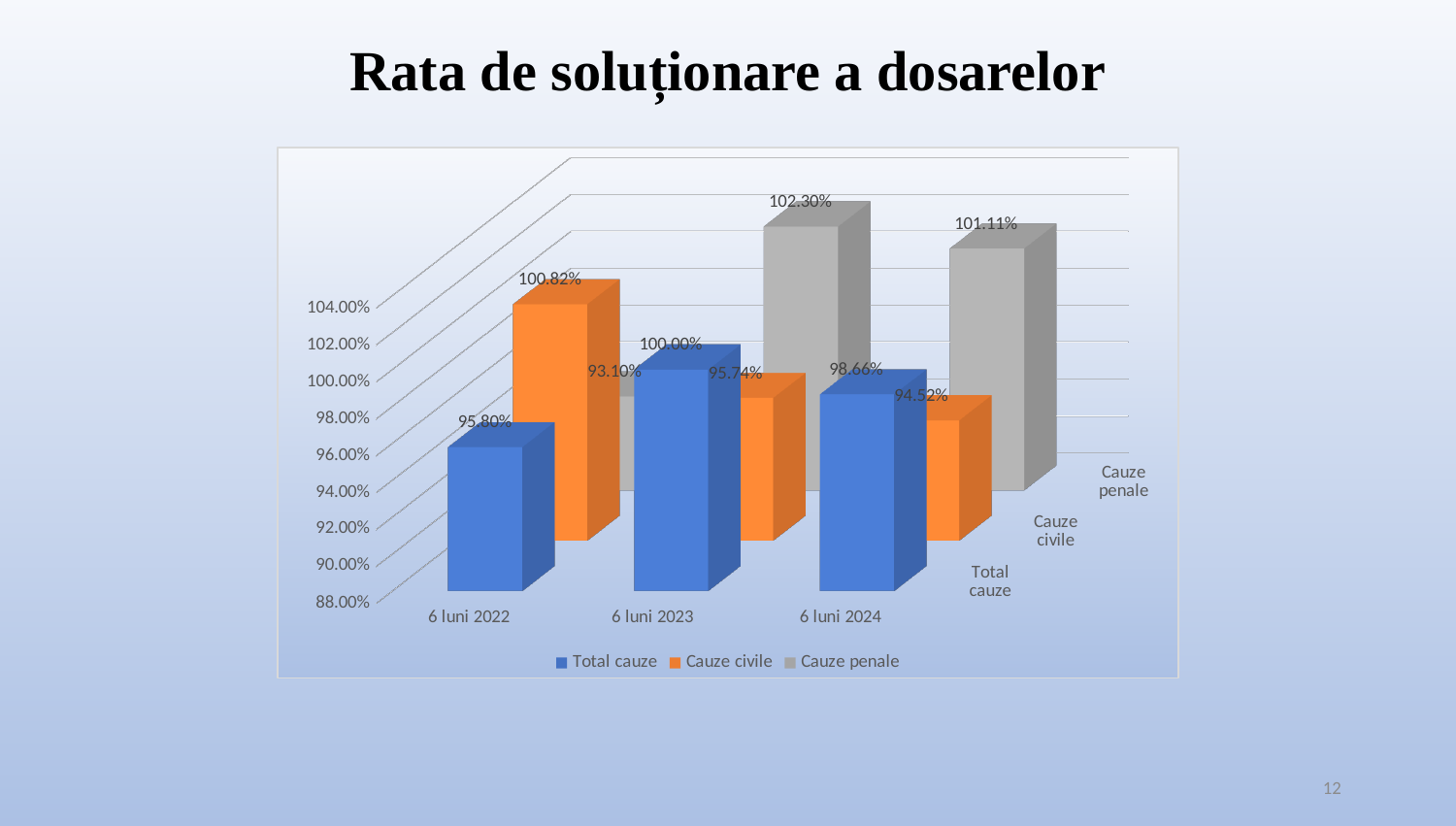
Which is larger: Cauze civile in 6 luni 2022 or Cauze civile in 6 luni 2023? 6 luni 2022 What is the title of the slide? Rata de soluționare a dosarelor What is the difference between the Total cauze values for 6 luni 2023 and 6 luni 2022? 4.20 percentage points What is the value for Cauze civile in 6 luni 2022? 100.82% What is the value for Cauze penale in 6 luni 2023? 102.30% How many periods are shown on the x axis? 3 In which period is the Total cauze value lowest? 6 luni 2022 What is the value for Total cauze in 6 luni 2024? 98.66% How many series does the legend list? 3 What is the value for Cauze civile in 6 luni 2024? 94.52% What is the value for Total cauze in 6 luni 2022? 95.80% What kind of chart is shown on the slide? bar chart